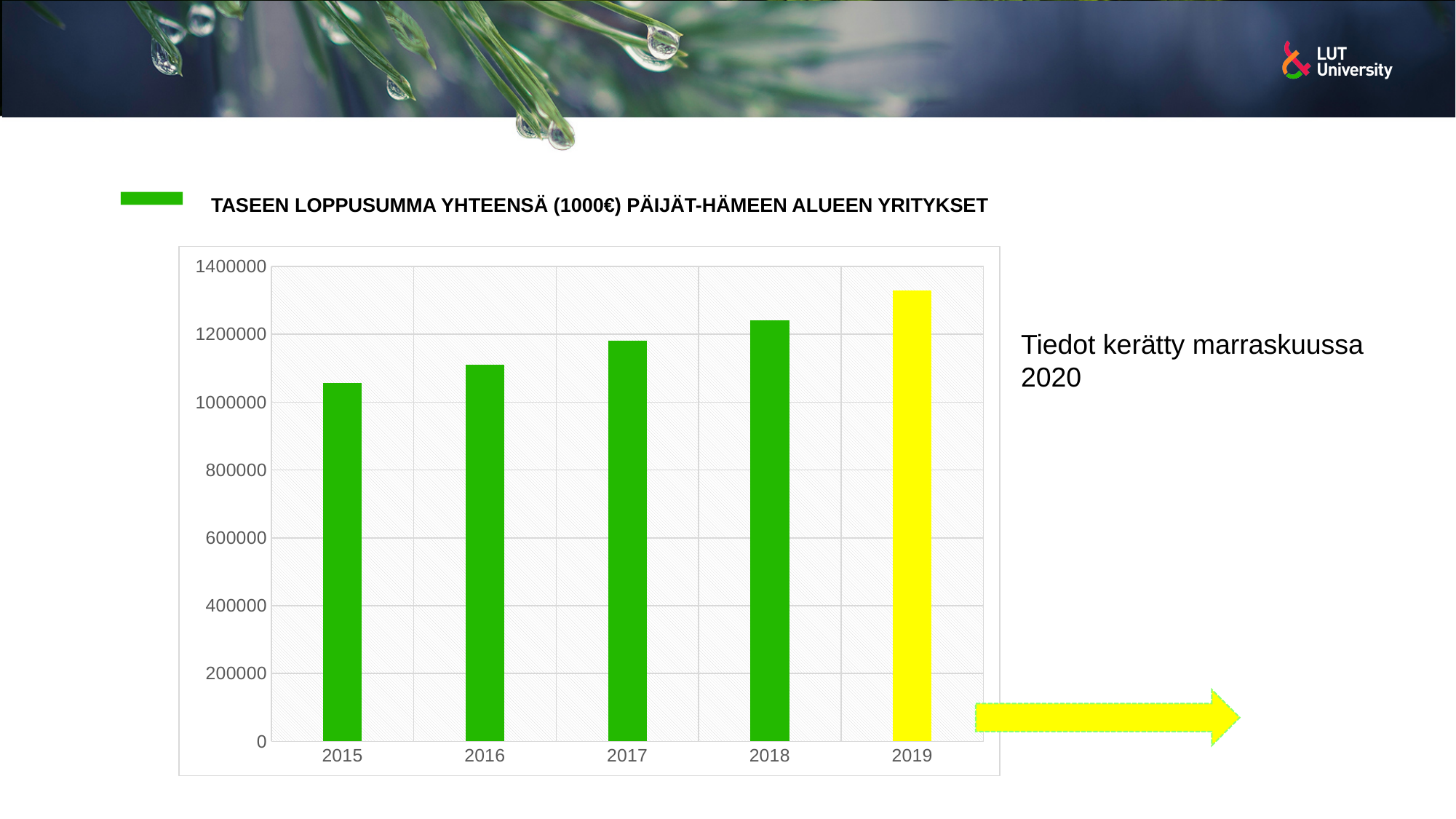
Is the value for 2019 greater or less than 1400000? less Which is larger, the value for 2019 or the value for 2015? 2019 Which year has the lowest value in the chart? 2015 Which is larger, the value for 2018 or the value for 2016? 2018 How many years are shown on the x axis of the chart? 5 Is the value for 2019 greater or less than 1200000? greater Is the value for 2015 greater or less than 1000000? greater Do the values rise or fall from 2015 to 2019? Rise Which year has the highest value in the chart? 2019 What is the title of the chart? TASEEN LOPPUSUMMA YHTEENSÄ (1000€) PÄIJÄT-HÄMEEN ALUEEN YRITYKSET What kind of chart is shown on the slide? Bar chart What colour is the bar for 2019? Yellow